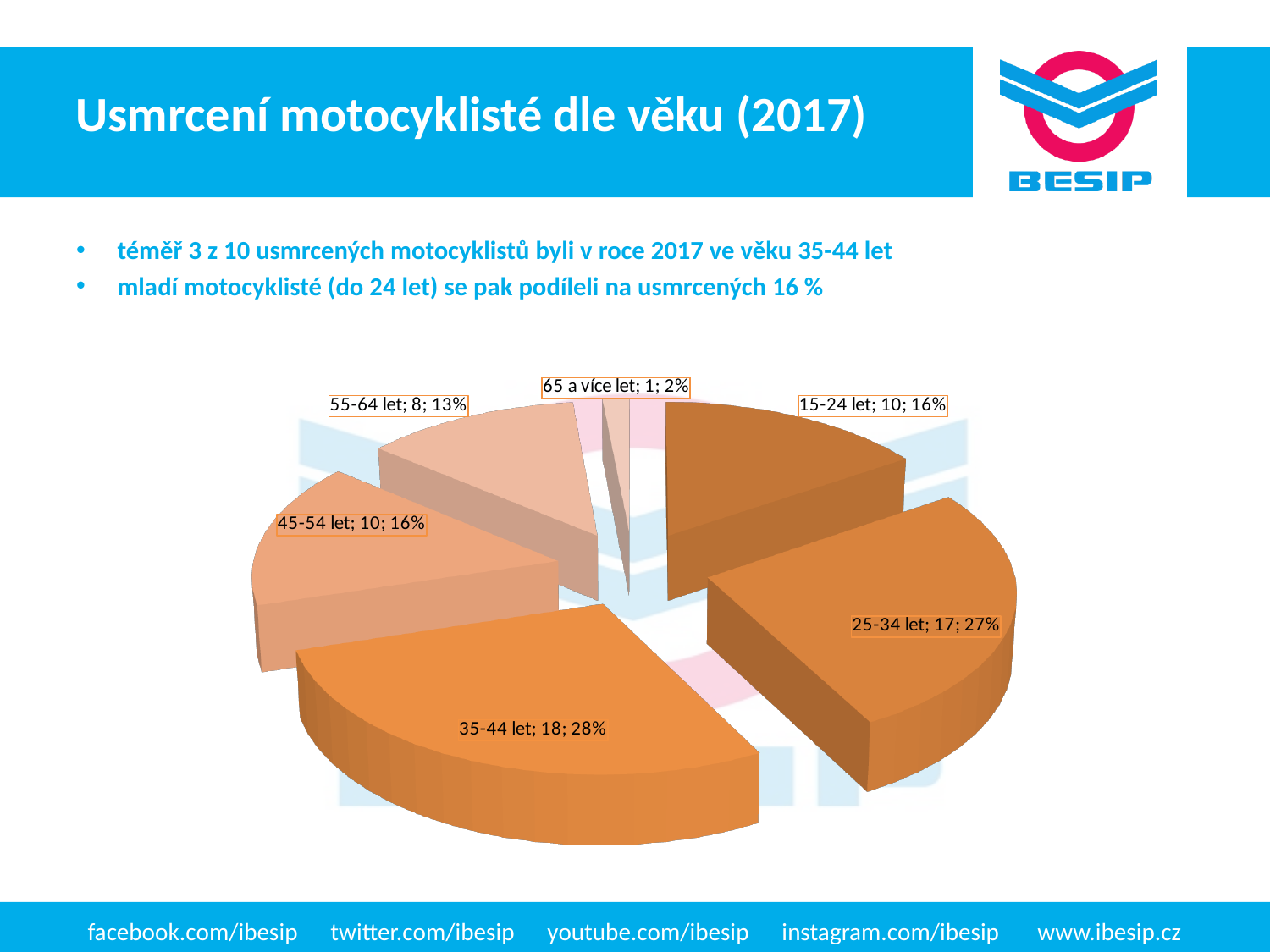
How many age categories does the pie chart show? 6 What is the title of the slide containing the chart? Usmrcení motocyklisté dle věku (2017) What is the value for the 65 a více let category? 1 What is the difference between the values for 35-44 let and 55-64 let? 10 How many killed motorcyclists were in the 25-34 let age group? 17 What kind of chart is shown on the slide? pie chart Which is larger, the value for 25-34 let or the value for 45-54 let? 25-34 let Which age group has the largest slice of the pie? 35-44 let What is the total of all the values shown in the pie chart? 64 What percentage share does the 55-64 let slice have? 13% Which age group has the smallest slice of the pie? 65 a více let What percentage share does the 15-24 let slice have? 16%